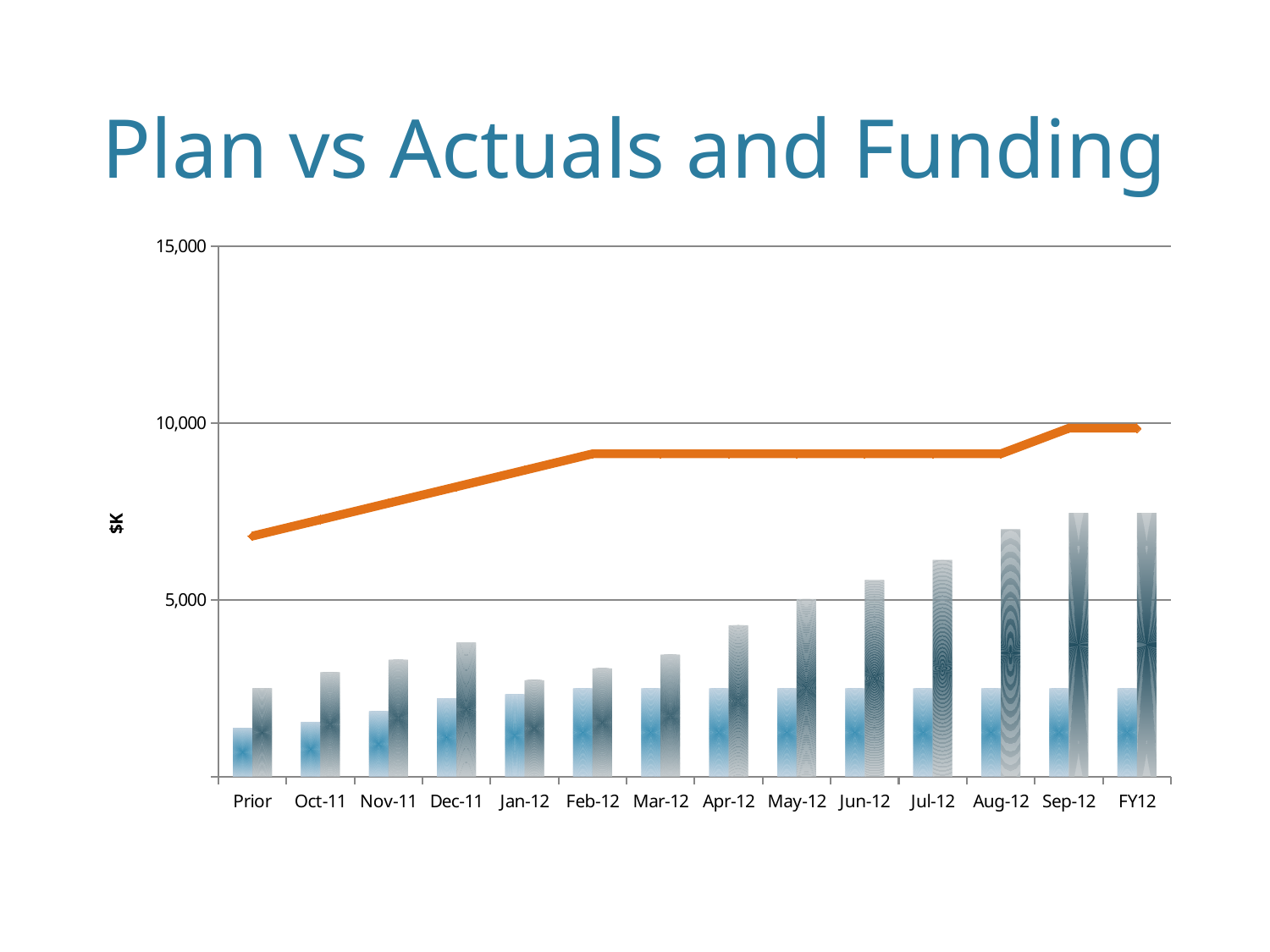
Is the value of the orange line at Feb-12 greater or less than 5,000? greater Is the value of the dark gray bar at Sep-12 greater or less than 5,000? greater Is the value of the dark gray bar at Prior greater or less than 5,000? less Does the orange line generally rise or fall from Prior to FY12? Rise What is the label on the vertical axis of the chart? $K Which category has the lowest dark gray bar? Prior What is the title of the chart on the slide? Plan vs Actuals and Funding What kind of chart is shown on the slide? Combined bar and line chart How many categories are shown along the x axis of the chart? 14 Which is higher, the orange line at Feb-12 or the orange line at Prior? Feb-12 Which is larger, the dark gray bar at Aug-12 or the dark gray bar at Apr-12? Aug-12